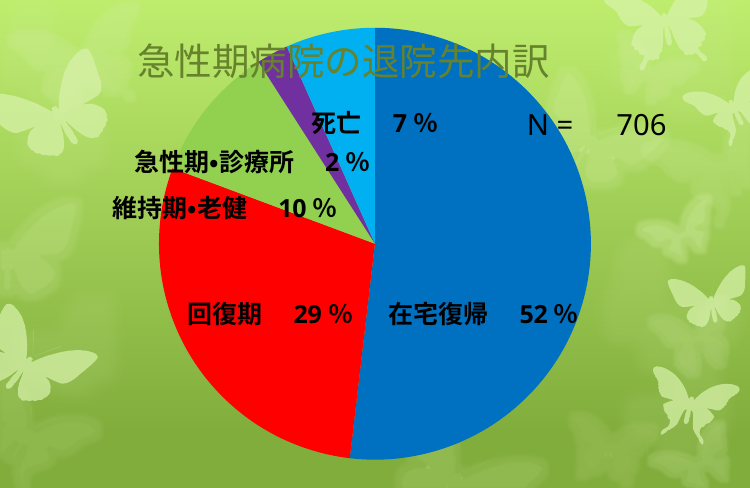
What is the value of N shown on the chart? 706 Which category has the largest share of the pie? 在宅復帰 Which category has the smallest share of the pie? 急性期・診療所 What percentage of the pie is 維持期・老健? 10% What is the title of the chart? 急性期病院の退院先内訳 What percentage of the pie is 急性期・診療所? 2% What is the difference in percentage points between 在宅復帰 and 回復期? 23 How many slices does the pie chart have? 5 What percentage of the pie is 回復期? 29% What percentage of the pie is 死亡? 7% What percentage of the pie is 在宅復帰? 52% What kind of chart is shown on the slide? pie chart